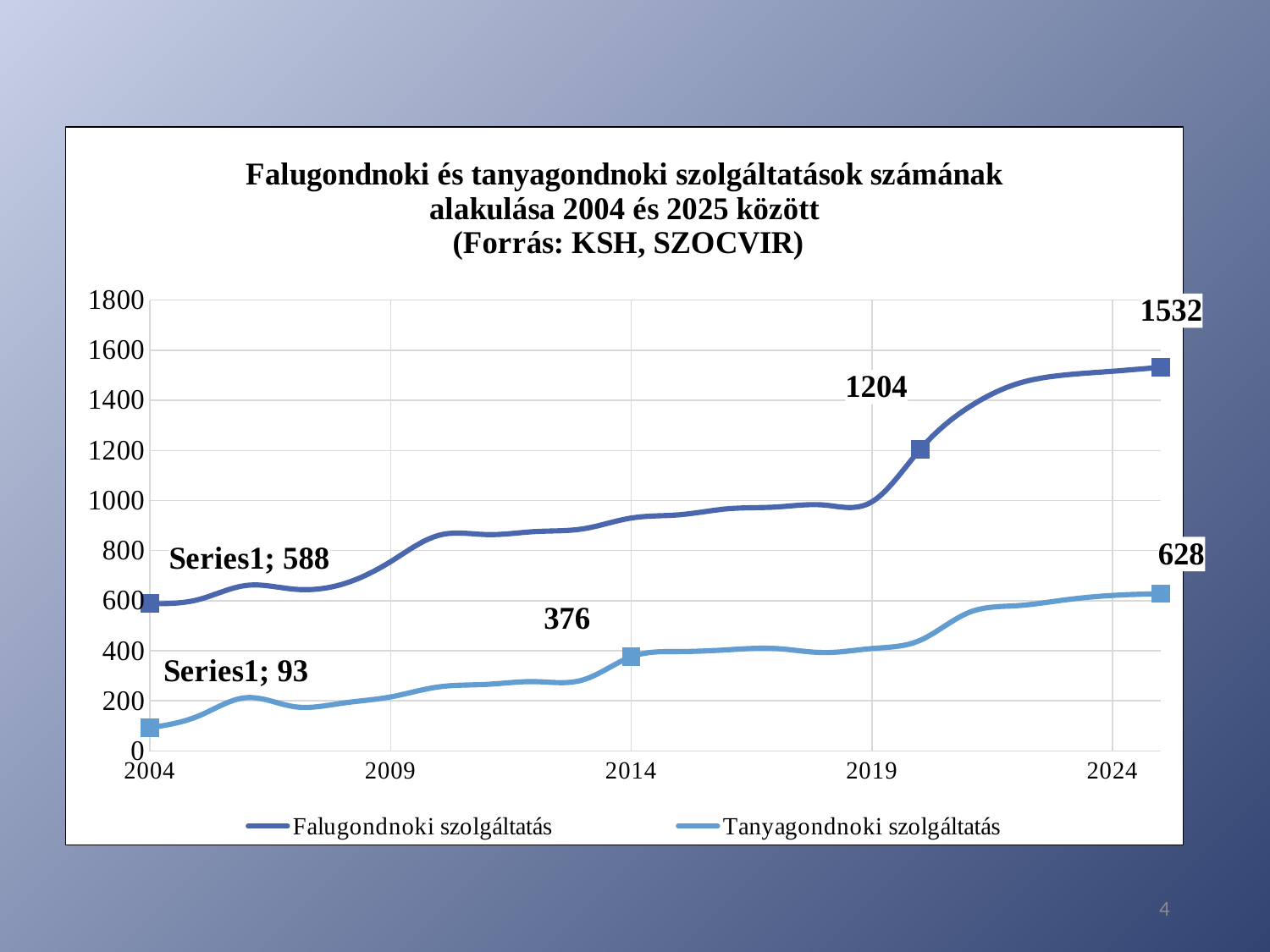
By how much did Falugondnoki szolgáltatás grow from its 2004 value (588) to its final labelled value (1532)? 944 How many series does the legend list? 2 What is the value of Falugondnoki szolgáltatás in 2004? 588 What is the value labelled at the last point of the Tanyagondnoki szolgáltatás line? 628 Which series has the higher value in 2014, Falugondnoki szolgáltatás or Tanyagondnoki szolgáltatás? Falugondnoki szolgáltatás What is the difference between the final labelled values of Falugondnoki szolgáltatás (1532) and Tanyagondnoki szolgáltatás (628)? 904 What is the value of Tanyagondnoki szolgáltatás in 2014? 376 Is the value of Tanyagondnoki szolgáltatás in 2019 greater or less than 600? less Does the Falugondnoki szolgáltatás line generally rise or fall from 2004 to the end of the period? rise What is the value of Tanyagondnoki szolgáltatás in 2004? 93 What is the value labelled at the last point of the Falugondnoki szolgáltatás line? 1532 What type of chart is shown on the slide? line chart